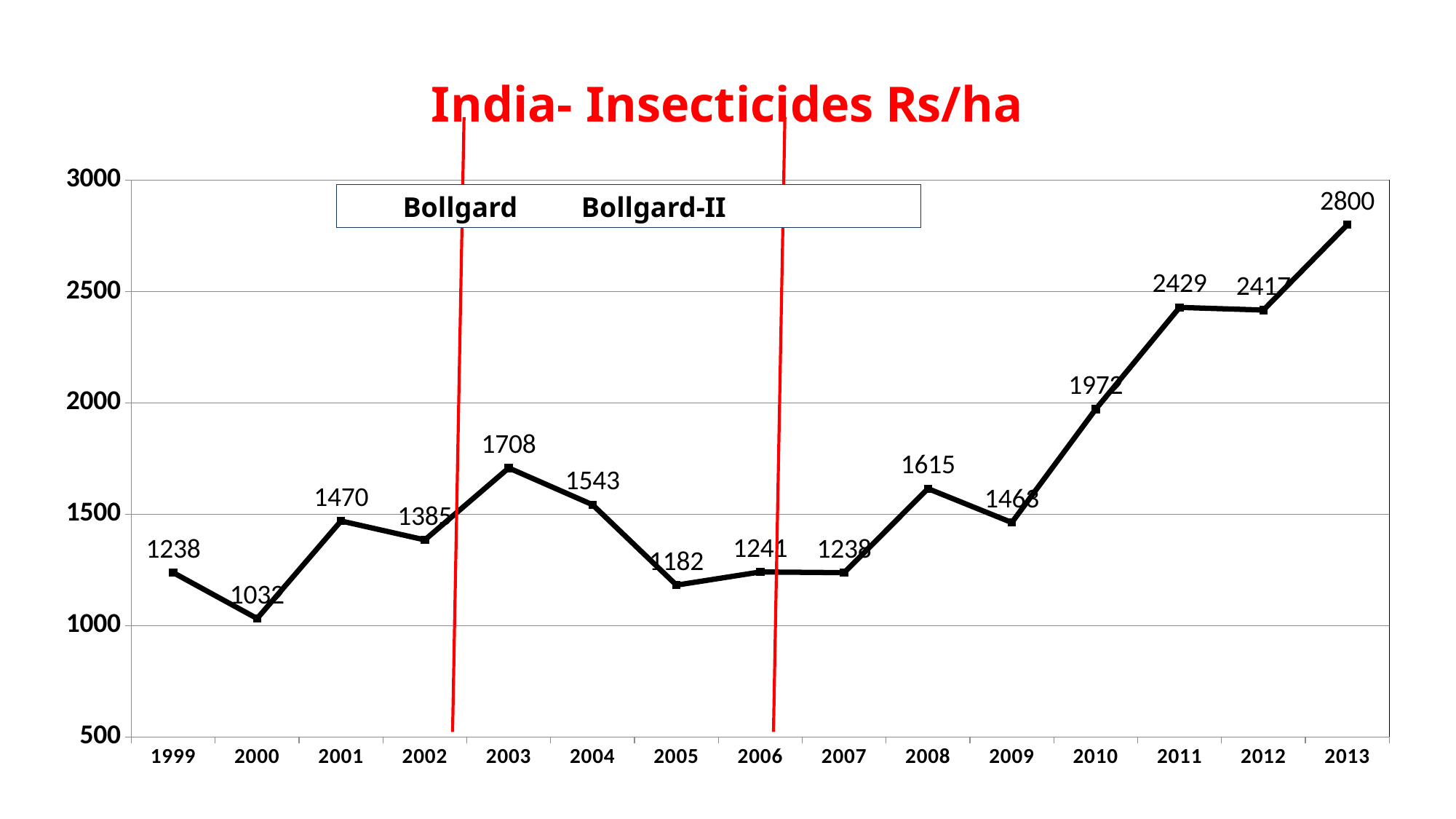
What is the value for 2003? 1708 What is the value for 2010? 1972 What is the difference between the values for 2013 and 1999? 1562 Do the values rise or fall from 2009 to 2013? rise Which year has the lowest value? 2000 What kind of chart is shown? line chart Is the value for 2011 greater or less than 2000? greater What is the value for 2000? 1032 What is the difference between the values for 2003 and 2004? 165 Which is larger, the value for 2008 or the value for 2009? 2008 Which year has the highest value? 2013 How many years are plotted on the chart? 15